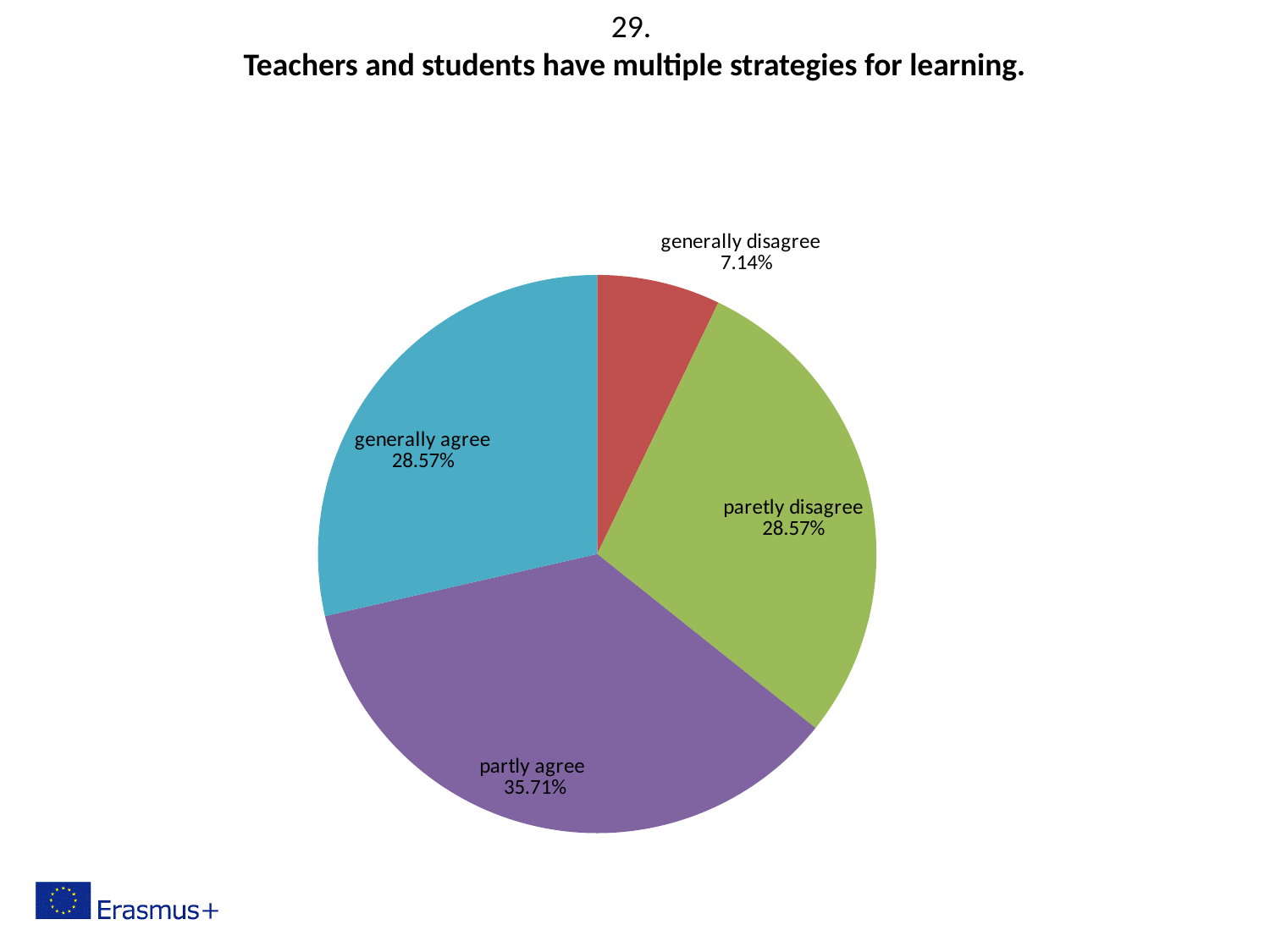
What share of the pie is labelled "partly agree"? 35.71% Which is larger, the "partly agree" slice or the "generally agree" slice? partly agree What kind of chart is shown on the slide? pie chart What share of the pie is labelled "paretly disagree"? 28.57% What share of the pie is labelled "generally disagree"? 7.14% How many slices does the pie chart have? 4 Which slice of the pie is the largest? partly agree What is the title of the chart on the slide? Teachers and students have multiple strategies for learning. What colour is the "partly agree" slice? purple What is the difference between the "partly agree" share and the "generally disagree" share? 28.57% Which slice of the pie is the smallest? generally disagree